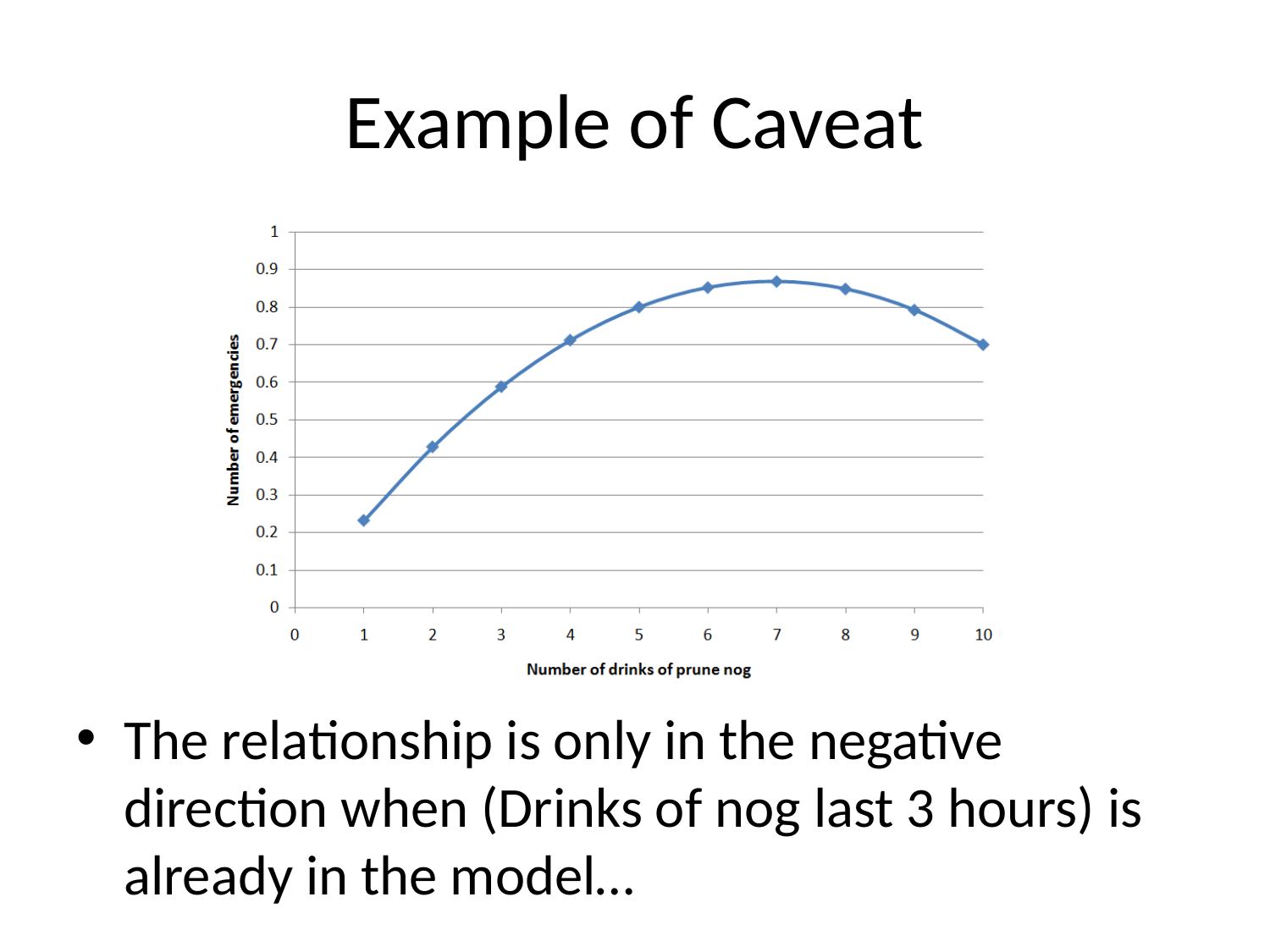
At which number of drinks of prune nog is the number of emergencies lowest? 1 What kind of chart is shown on the slide? line chart Is the number of emergencies at 2 drinks of prune nog greater or less than 0.5? less Is the number of emergencies at 1 drink of prune nog greater or less than 0.3? less What is the label of the x axis of the chart? Number of drinks of prune nog Is the number of emergencies at 3 drinks of prune nog greater or less than 0.5? greater Does the number of emergencies rise or fall as the number of drinks increases from 7 to 10? fall Which has a higher number of emergencies: 2 drinks of prune nog or 9 drinks of prune nog? 9 drinks At which number of drinks of prune nog is the number of emergencies highest? 7 How many data points are plotted on the chart? 10 Does the number of emergencies rise or fall as the number of drinks increases from 1 to 7? rise